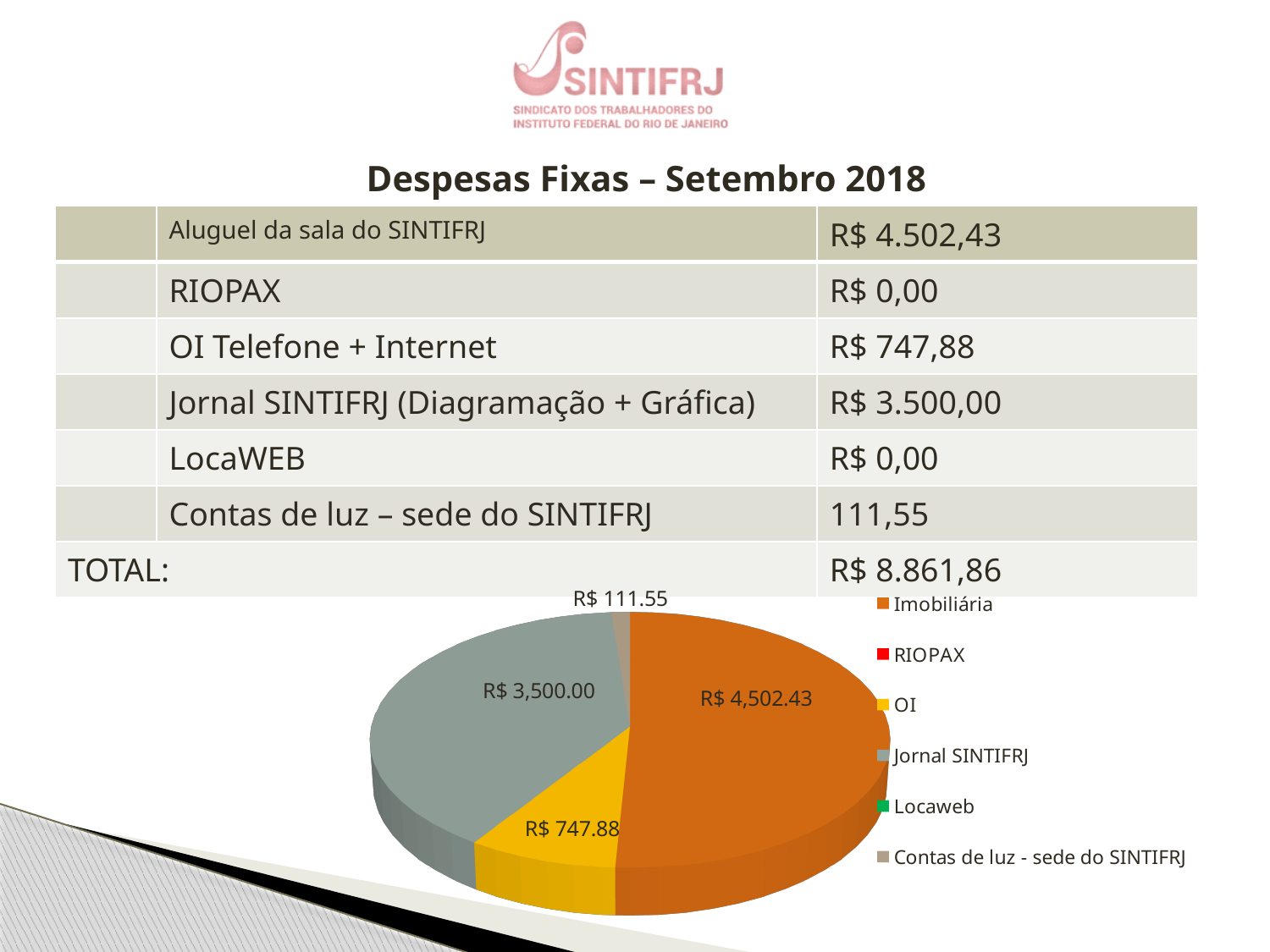
What value is labelled on the Contas de luz - sede do SINTIFRJ slice of the pie chart? R$ 111.55 What value is labelled on the OI slice of the pie chart? R$ 747.88 How many slices in the pie chart carry a data label? 4 How many entries does the legend of the pie chart list? 6 What colour is the Imobiliária slice in the pie chart? Orange What is the difference between the OI value and the Contas de luz - sede do SINTIFRJ value in the pie chart? R$ 636.33 What kind of chart is shown on the slide? Pie chart What value is labelled on the Jornal SINTIFRJ slice of the pie chart? R$ 3,500.00 What value is labelled on the Imobiliária slice of the pie chart? R$ 4,502.43 Which is larger in the pie chart, the Jornal SINTIFRJ slice or the OI slice? Jornal SINTIFRJ Which category has the largest slice in the pie chart? Imobiliária What is the difference between the Imobiliária value and the Jornal SINTIFRJ value in the pie chart? R$ 1,002.43